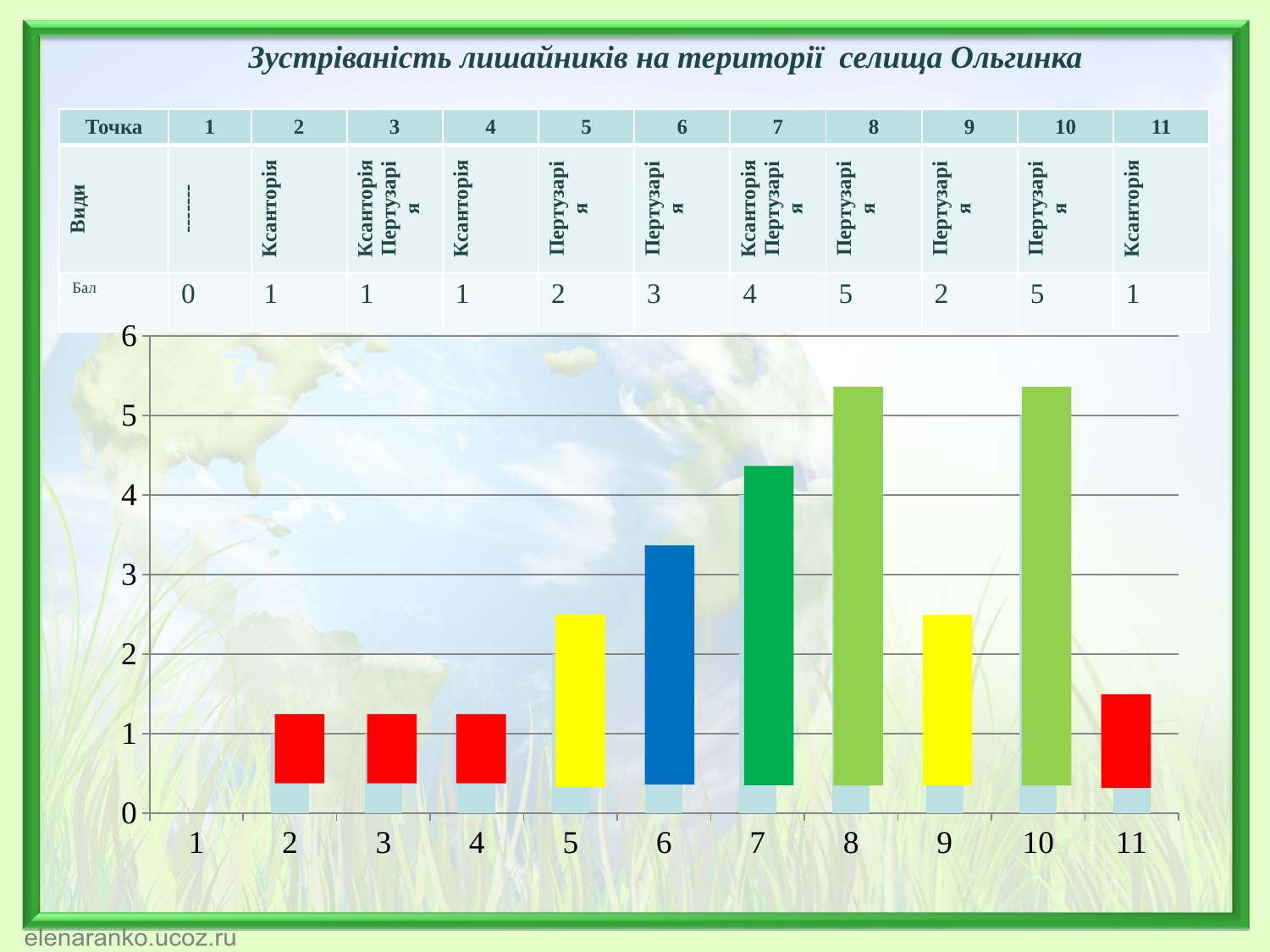
What is the title of the slide with the chart? Зустріваність лишайників на території селища Ольгинка How many points (категорії) are labelled along the x axis of the chart? 11 Which point on the x axis has no bar at all (a value of 0)? 1 What kind of chart is shown on the slide? bar chart Is the bar for point 9 greater or less than 3? less Which bar is taller, point 7 or point 6? point 7 What colour is the bar for point 6? blue Which bar is taller, point 5 or point 2? point 5 According to the table above the chart, what is the score (Бал) for point 10? 5